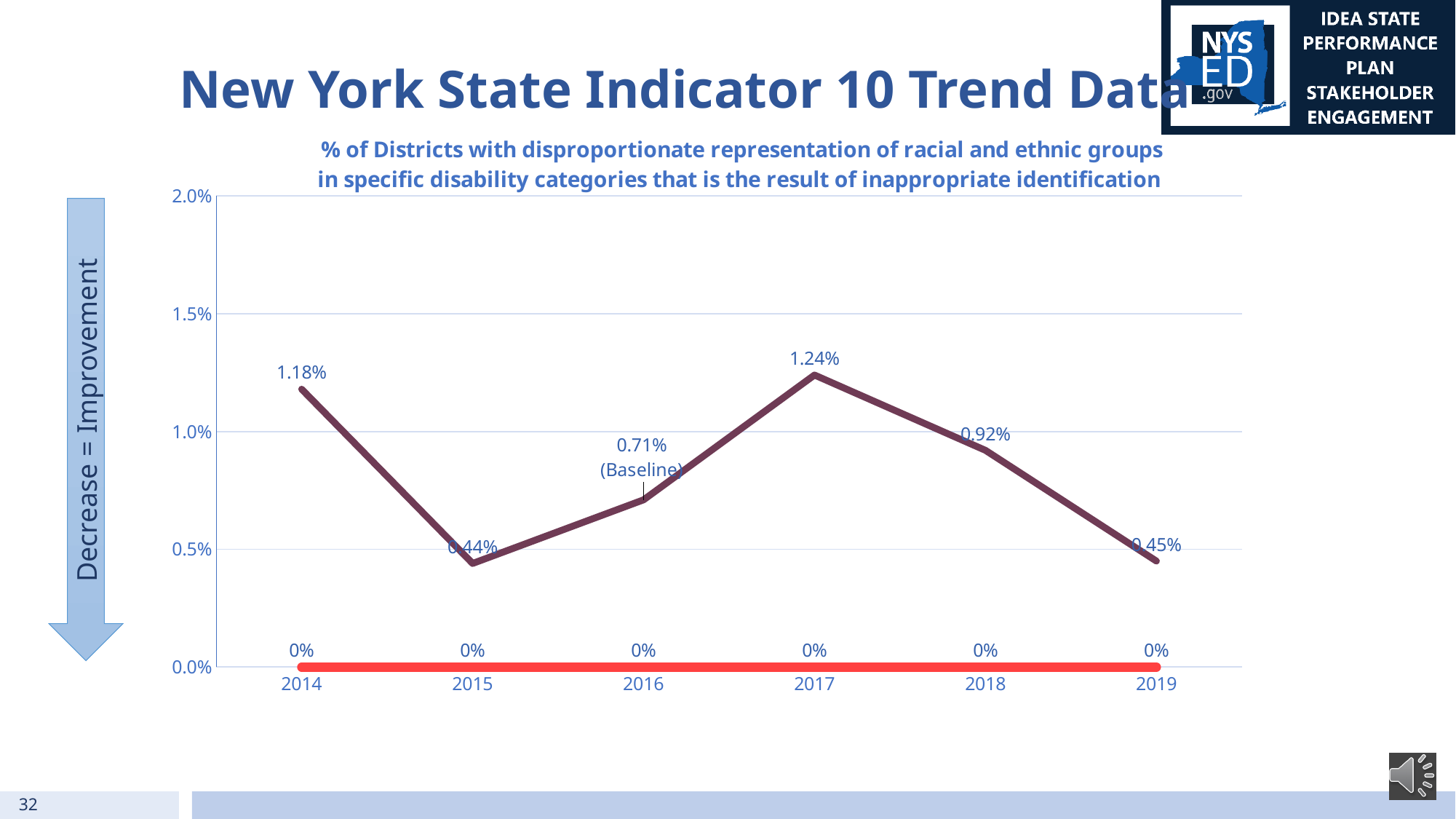
What is the value of the dark line for 2017? 1.24% In which year does the dark line reach its highest value? 2017 Which is larger, the dark line's value for 2014 or for 2018? 2014 How many years are shown on the x axis? 6 Which year is labelled as the baseline on the chart? 2016 In which year does the dark line reach its lowest value? 2015 What type of chart is shown on the slide? line chart What is the value of the dark line for 2019? 0.45% What is the value of the dark line for 2014? 1.18% What is the difference between the dark line's values for 2017 and 2016? 0.53% What value does the red line show for every year? 0% What is the value of the dark line for 2018? 0.92%